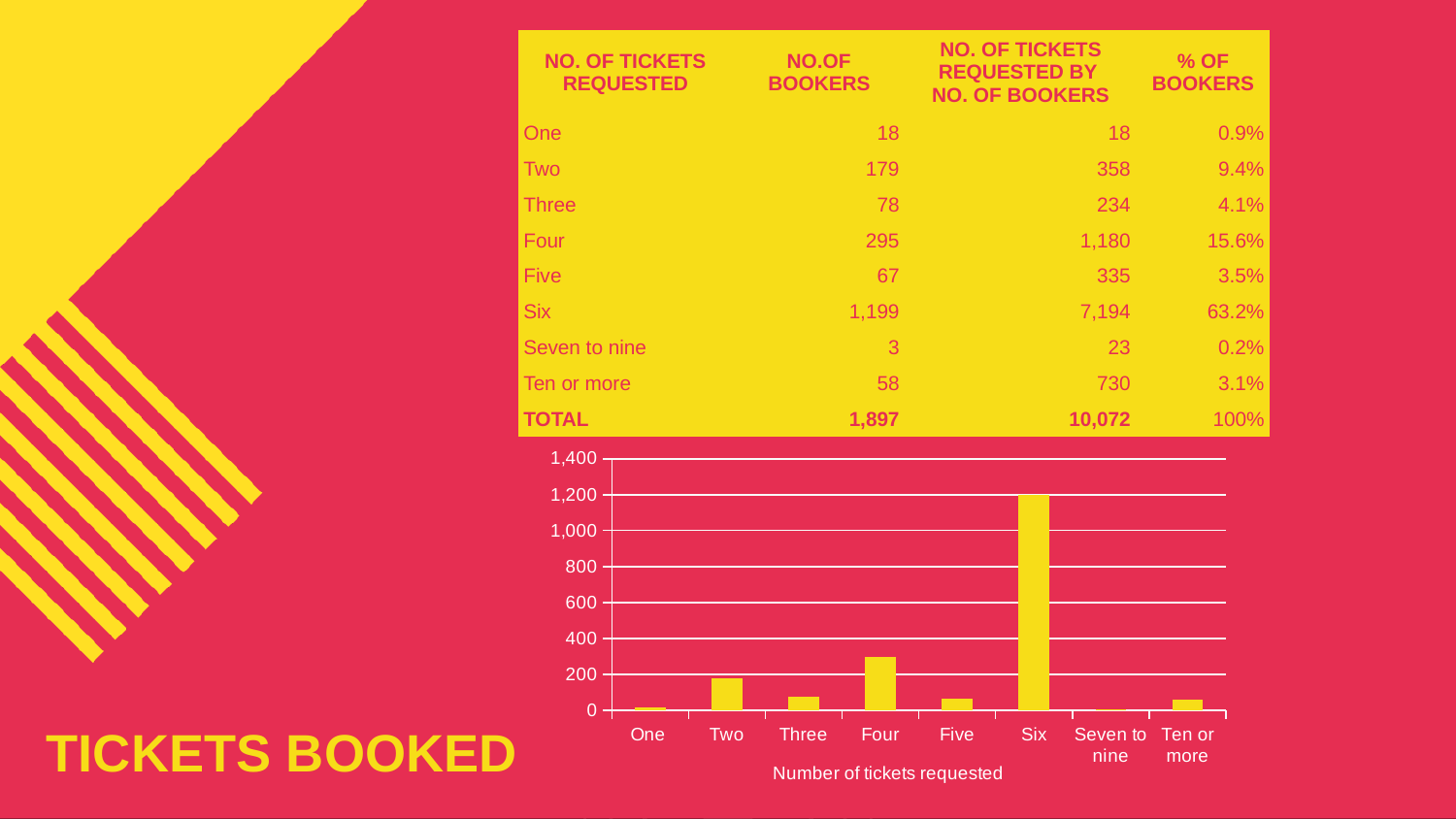
Which bar is taller, Two or Three? Two How many categories are shown on the x axis of the chart? 8 Which bar is taller, Four or Two? Four Is the value for Ten or more greater or less than 200? less What kind of chart is shown on the slide? bar chart Is the value for Two greater or less than 200? less Is the value for Six greater or less than 1,000? greater What is the title of the x axis of the chart? Number of tickets requested What is the highest value shown on the y axis of the chart? 1,400 Which category has the tallest bar in the chart? Six